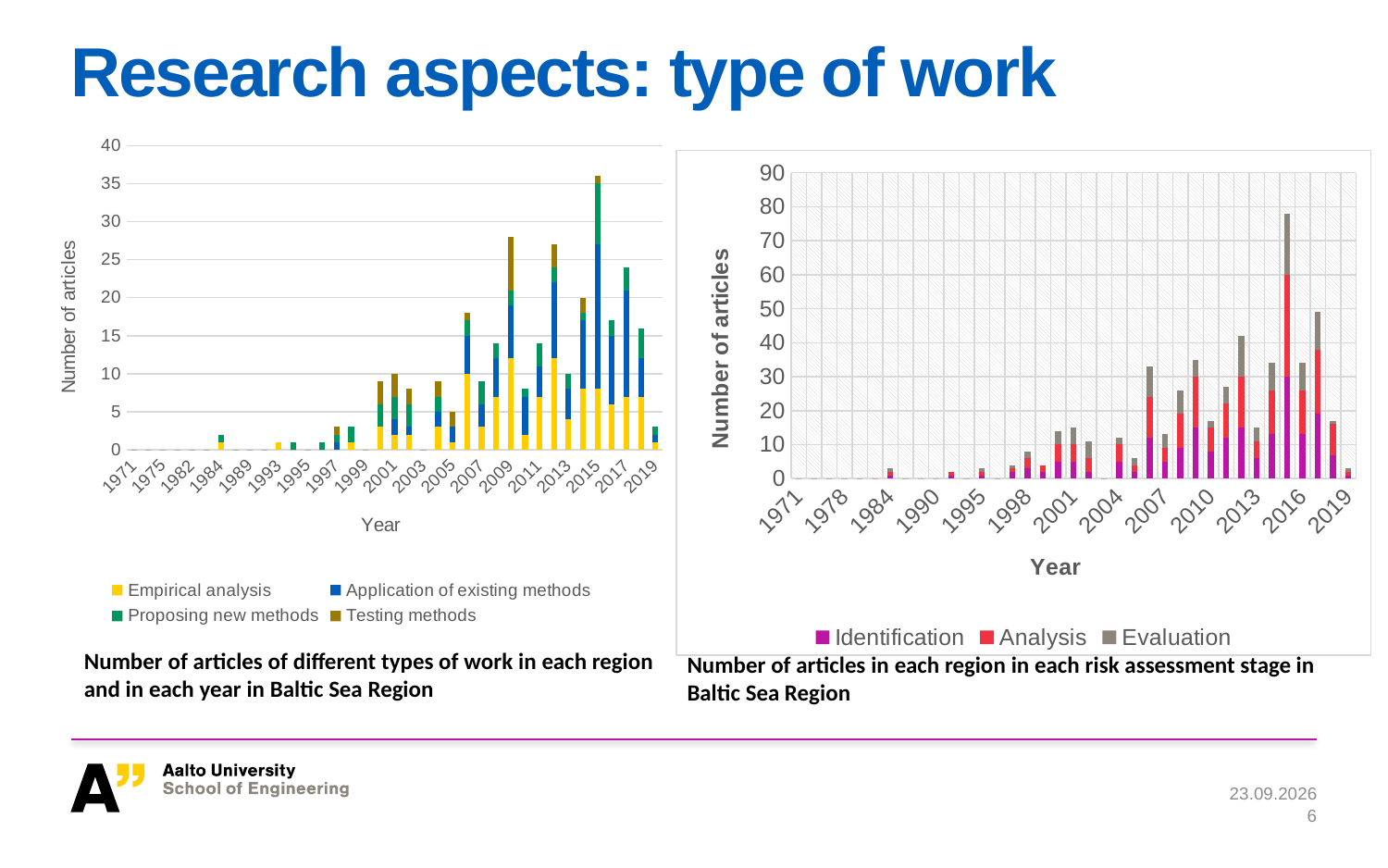
How many series does the legend of the right chart list? 3 What kind of chart is the left chart, 'Number of articles of different types of work in each region and in each year in Baltic Sea Region'? Stacked bar chart In the right chart, which series is shown in red? Analysis In the left chart, which year has the tallest stacked bar? 2015 In the right chart, is the total for 2016 greater or less than 70? less What are the legend entries of the left chart? Empirical analysis, Application of existing methods, Proposing new methods, Testing methods In the left chart, is the total for 2015 greater or less than 30? greater How many series does the legend of the left chart list? 4 In the right chart, which year has the larger total, 2013 or 2016? 2016 What kind of chart is the right chart, 'Number of articles in each region in each risk assessment stage in Baltic Sea Region'? Stacked bar chart In the right chart, is the total for 2019 greater or less than 10? less In the right chart, which year has the tallest stacked bar? 2015